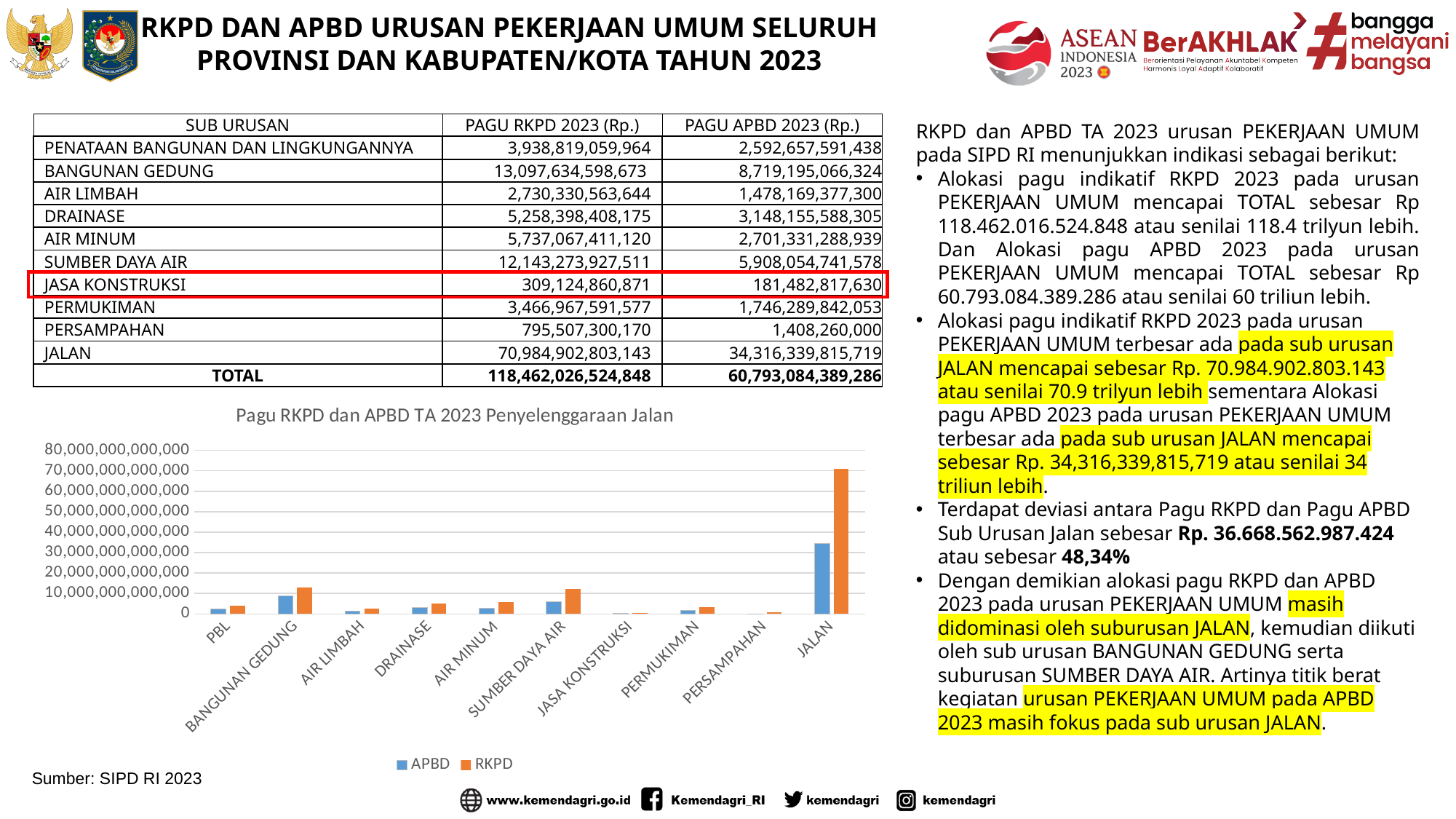
Which is larger: the APBD bar for BANGUNAN GEDUNG or the APBD bar for SUMBER DAYA AIR? BANGUNAN GEDUNG Is the RKPD value for PBL greater or less than 10,000,000,000,000? less Which colour represents the RKPD series in the chart? Orange How many series does the chart legend list? 2 What is the title of the chart? Pagu RKPD dan APBD TA 2023 Penyelenggaraan Jalan Which category has the highest APBD bar in the chart? JALAN Is the APBD value for JALAN greater or less than 30,000,000,000,000? greater How many categories are shown on the x axis of the chart? 10 Is the RKPD value for JALAN greater or less than 60,000,000,000,000? greater For JALAN, which is larger: the APBD bar or the RKPD bar? RKPD What kind of chart is shown on the slide? Bar chart Which category has the highest RKPD bar in the chart? JALAN